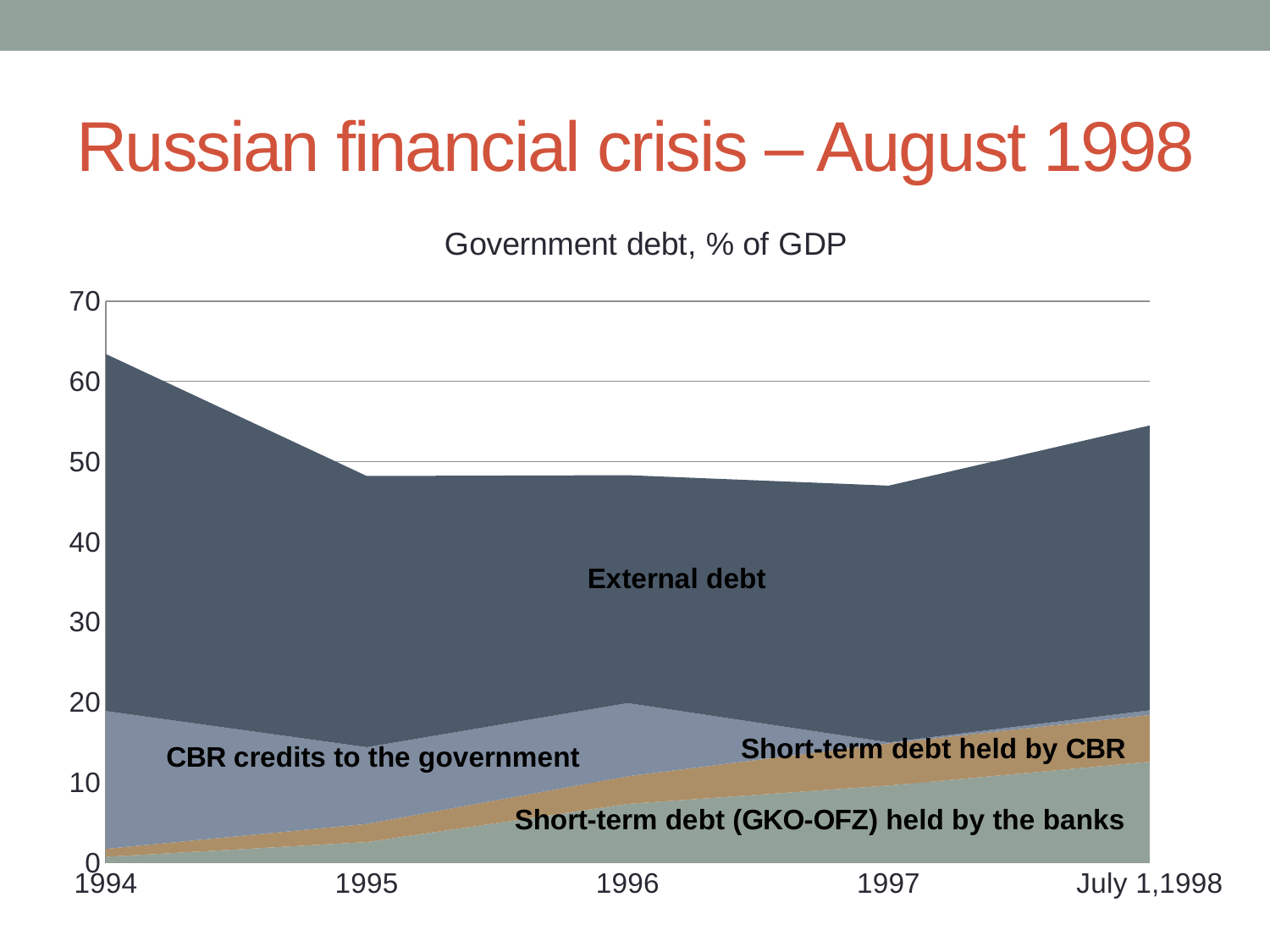
Which is larger: total government debt in 1994 or on July 1, 1998? 1994 Is total government debt in 1997 greater or less than 50% of GDP? less Which series occupies the largest (top) area of the chart? External debt What is the title of the chart? Government debt, % of GDP Is total government debt on July 1, 1998 greater or less than 50% of GDP? greater Does total government debt rise or fall from 1994 to 1995? fall Is total government debt in 1994 greater or less than 60% of GDP? greater In which year is total government debt as % of GDP highest? 1994 How many debt components (series) are labelled in the chart? 4 What kind of chart is shown on the slide? Stacked area chart How many time points are shown on the x axis of the chart? 5 Does short-term debt (GKO-OFZ) held by the banks rise or fall from 1994 to July 1, 1998? rise